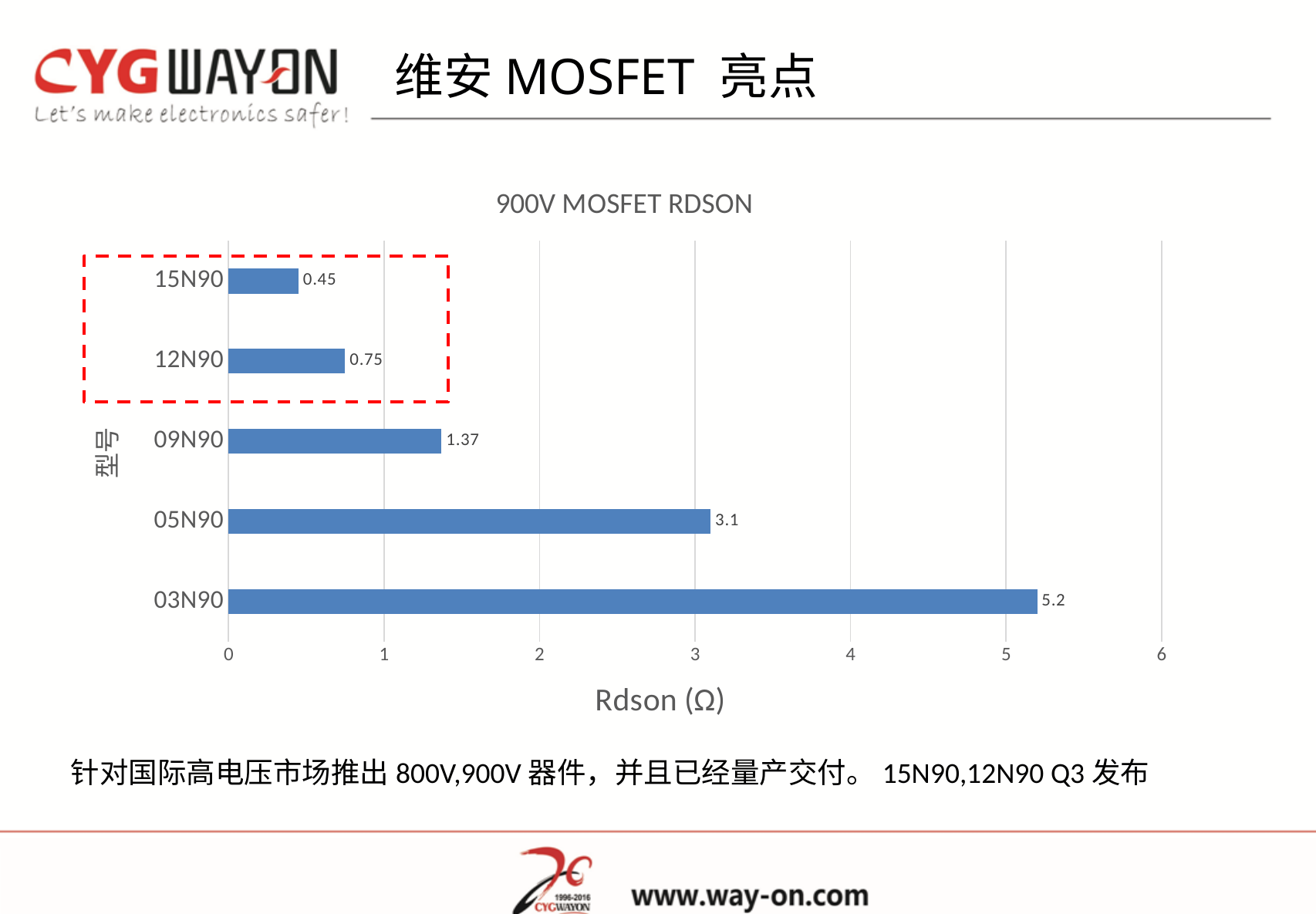
What is the difference in Rdson between 05N90 and 12N90? 2.35 How many models are shown in the chart? 5 Is the Rdson value for 05N90 greater or less than 3? greater Which has a larger Rdson, 12N90 or 09N90? 09N90 What is the label of the horizontal axis? Rdson (Ω) What is the Rdson value for 15N90? 0.45 Which model has the lowest Rdson? 15N90 What is the Rdson value for 09N90? 1.37 What is the title of the chart? 900V MOSFET RDSON What is the Rdson value for 03N90? 5.2 What kind of chart is shown on the slide? bar chart Which model has the highest Rdson? 03N90